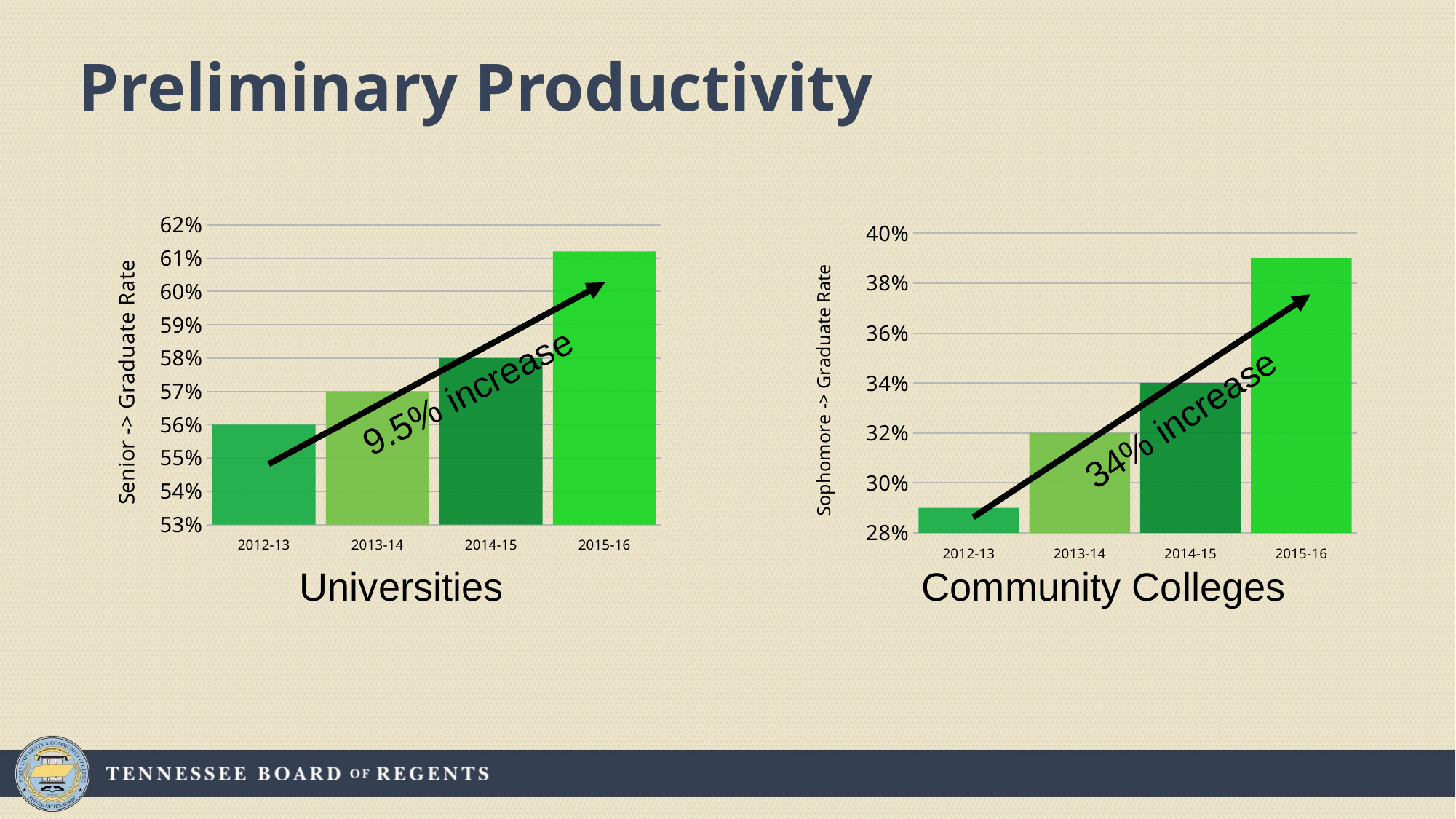
In the Community Colleges chart, which year has the lowest Sophomore -> Graduate Rate? 2012-13 In the Universities chart, is the value for 2015-16 greater or less than 60%? greater In the Universities chart, what is the difference between the values for 2014-15 and 2012-13? 2% In the Community Colleges chart, what is the value for 2014-15? 34% In the Community Colleges chart, what is the Sophomore -> Graduate Rate for 2013-14? 32% In the Community Colleges chart, is the value for 2012-13 greater or less than 30%? less In the Universities chart, what is the value for 2014-15? 58% What percentage increase is annotated on the Community Colleges chart? 34% increase What kind of chart is the Universities chart? bar chart How many years are shown on the x axis of the Community Colleges chart? 4 In the Universities chart, what is the Senior -> Graduate Rate for 2012-13? 56% In the Universities chart, which year has the highest Senior -> Graduate Rate? 2015-16